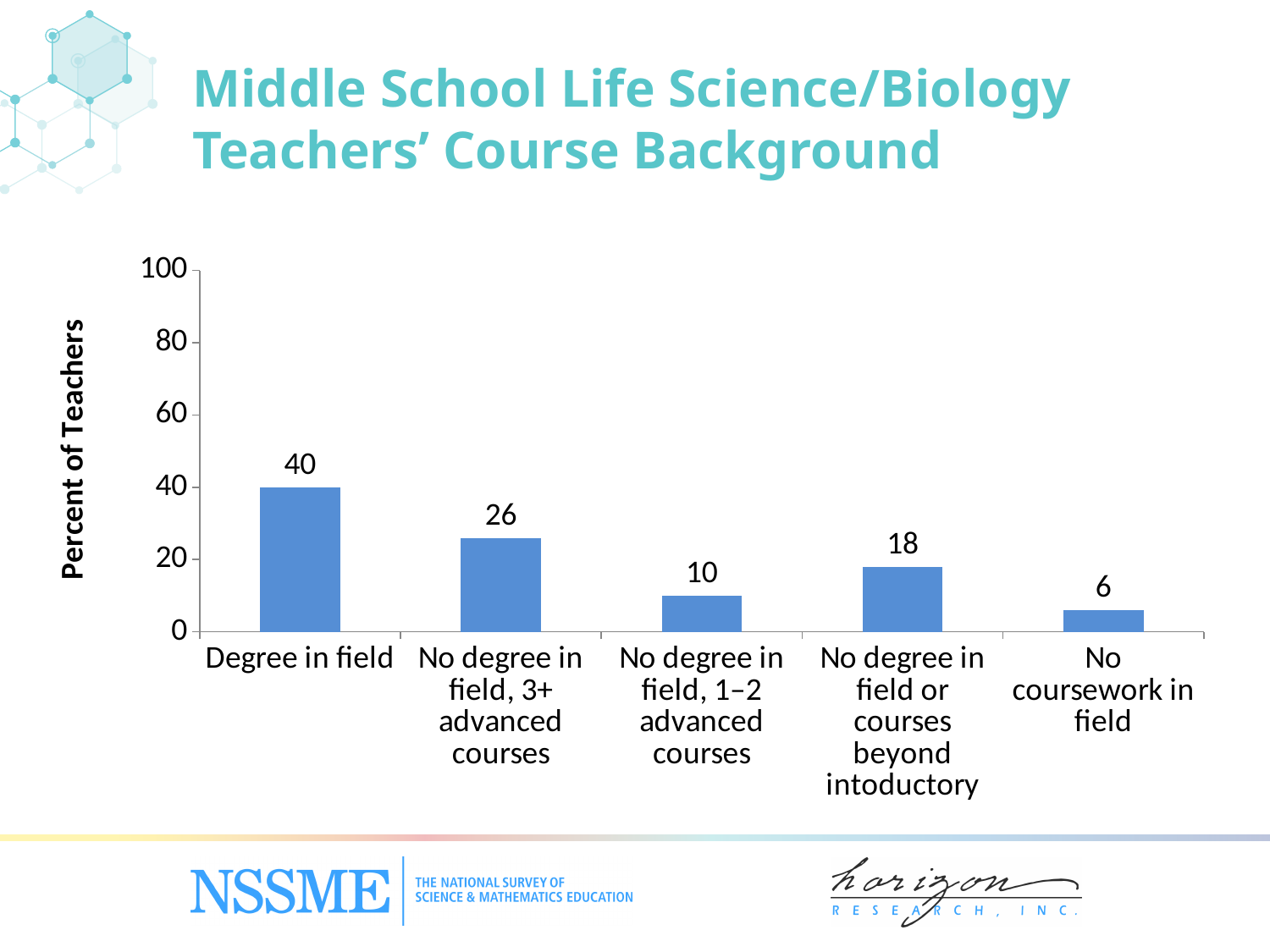
What is the value for 'No coursework in field'? 6 What is the difference between 'Degree in field' and 'No degree in field, 3+ advanced courses'? 14 How many categories are shown on the chart? 5 What is the value for 'No degree in field, 3+ advanced courses'? 26 Which category has the highest percent of teachers? Degree in field What kind of chart is shown on the slide? Bar chart What is the label of the vertical axis? Percent of Teachers Which is larger: 'No degree in field, 1–2 advanced courses' or 'No degree in field or courses beyond intoductory'? No degree in field or courses beyond intoductory Which category has the lowest percent of teachers? No coursework in field What is the value for 'No degree in field or courses beyond intoductory'? 18 What is the title of the slide? Middle School Life Science/Biology Teachers' Course Background What percent of teachers have a degree in field? 40